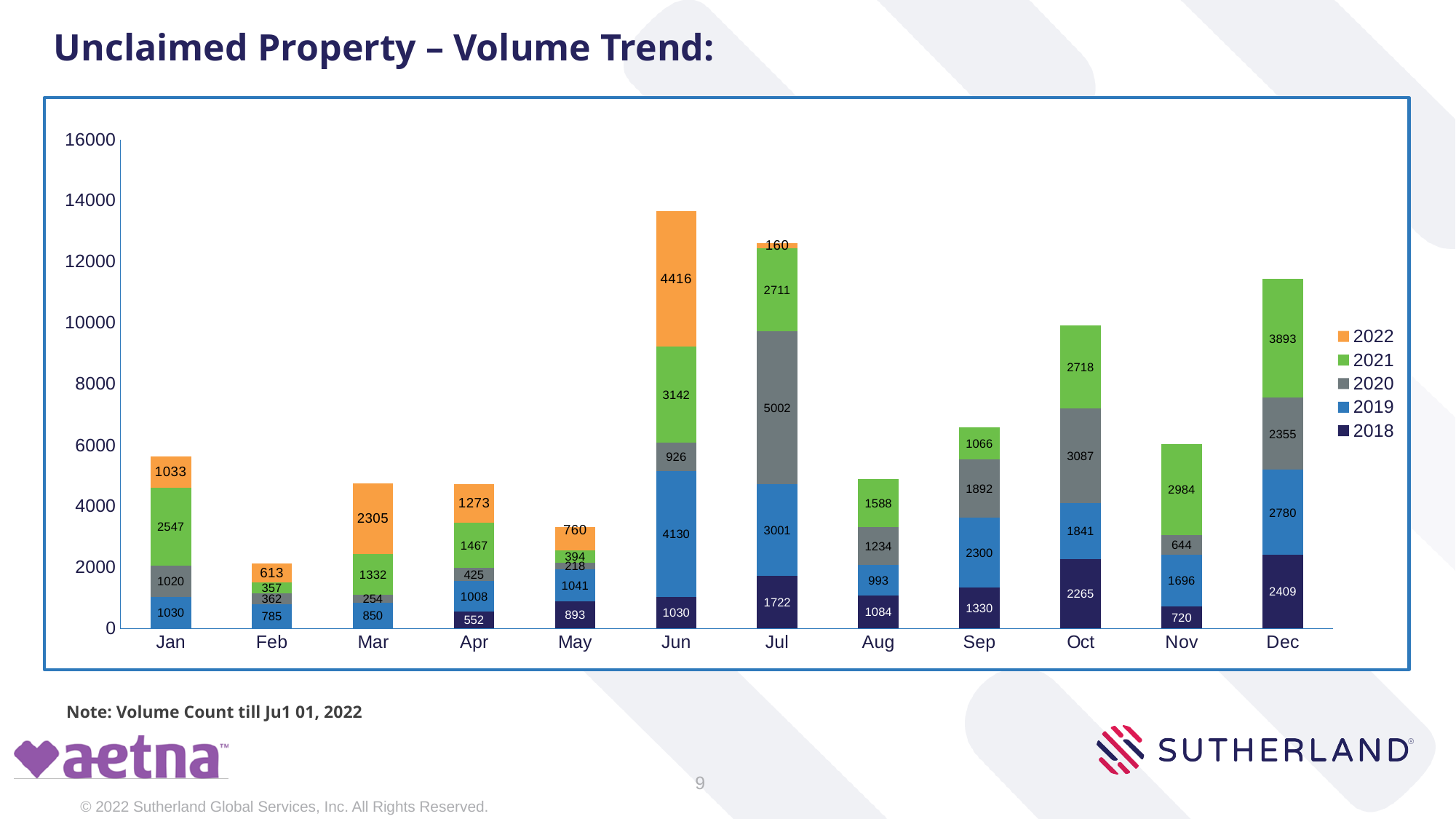
Is the total of the stacked bar for Oct greater or less than 8000? greater Which month has the shortest stacked bar overall? Feb Which month has the tallest stacked bar overall? Jun What is the 2022 value for Jun? 4416 What is the 2018 value for Oct? 2265 How many series does the legend list? 5 How many months are shown along the x axis? 12 Which month has the larger 2019 value, Jun or Jul? Jun What is the total of the stacked bar for Aug? 4899 What kind of chart is shown on the slide? Stacked bar chart What is the 2020 value for Jul? 5002 What is the difference between the 2021 value for Dec and the 2021 value for Nov? 909